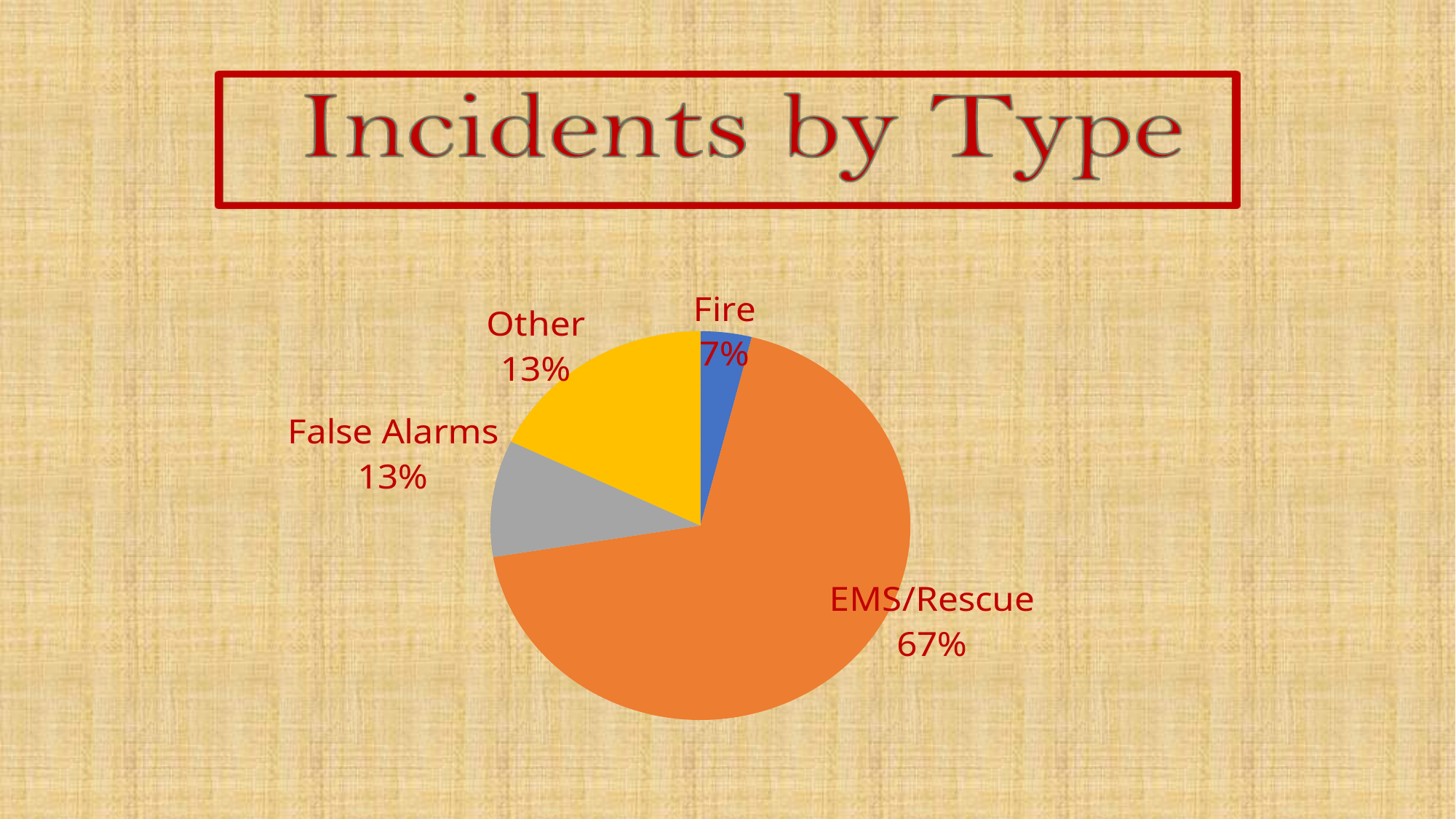
Which incident type has the smallest share of the pie? Fire What share of incidents is EMS/Rescue? 67% What share of incidents is Other? 13% Which is larger, the share for False Alarms or the share for Fire? False Alarms Which incident type has the largest share of the pie? EMS/Rescue What is the difference in percentage points between EMS/Rescue and Fire? 60 What is the title of the slide? Incidents by Type What kind of chart is shown on the slide? Pie chart What share of incidents is Fire? 7% How many incident types are shown in the pie chart? 4 What is the difference in percentage points between Other and Fire? 6